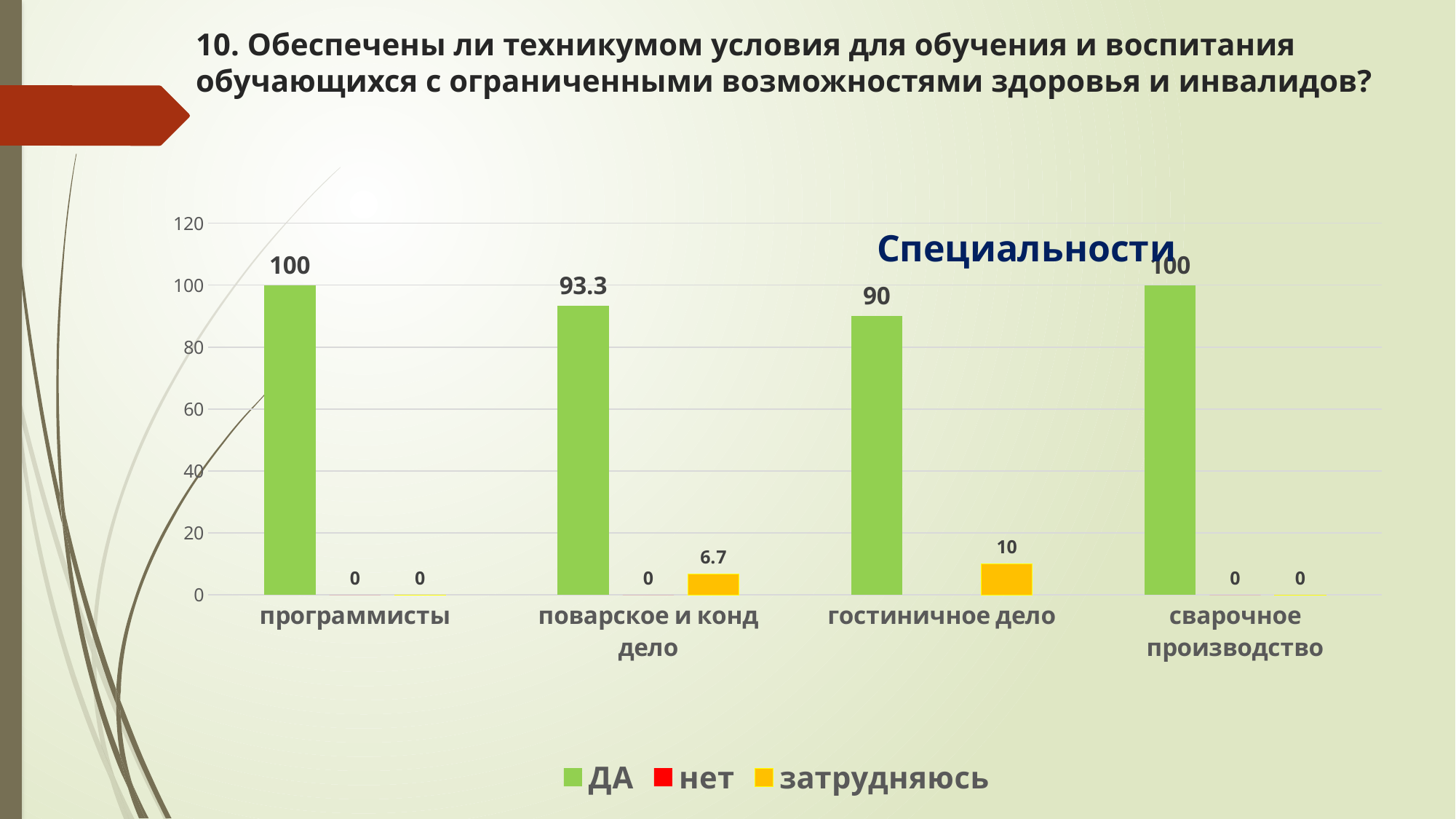
Which category has the highest value for затрудняюсь? гостиничное дело What is the value of затрудняюсь for поварское и конд дело? 6.7 What is the difference between the ДА values for программисты and гостиничное дело? 10 What is the value of нет for программисты? 0 What is the value of затрудняюсь for гостиничное дело? 10 Which category has the lowest value for ДА? гостиничное дело How many categories are shown on the x axis? 4 What is the value of ДА for поварское и конд дело? 93.3 How many series does the legend list? 3 What type of chart is shown on the slide? bar chart What is the value of ДА for гостиничное дело? 90 Which is larger: the ДА value for поварское и конд дело or for гостиничное дело? поварское и конд дело